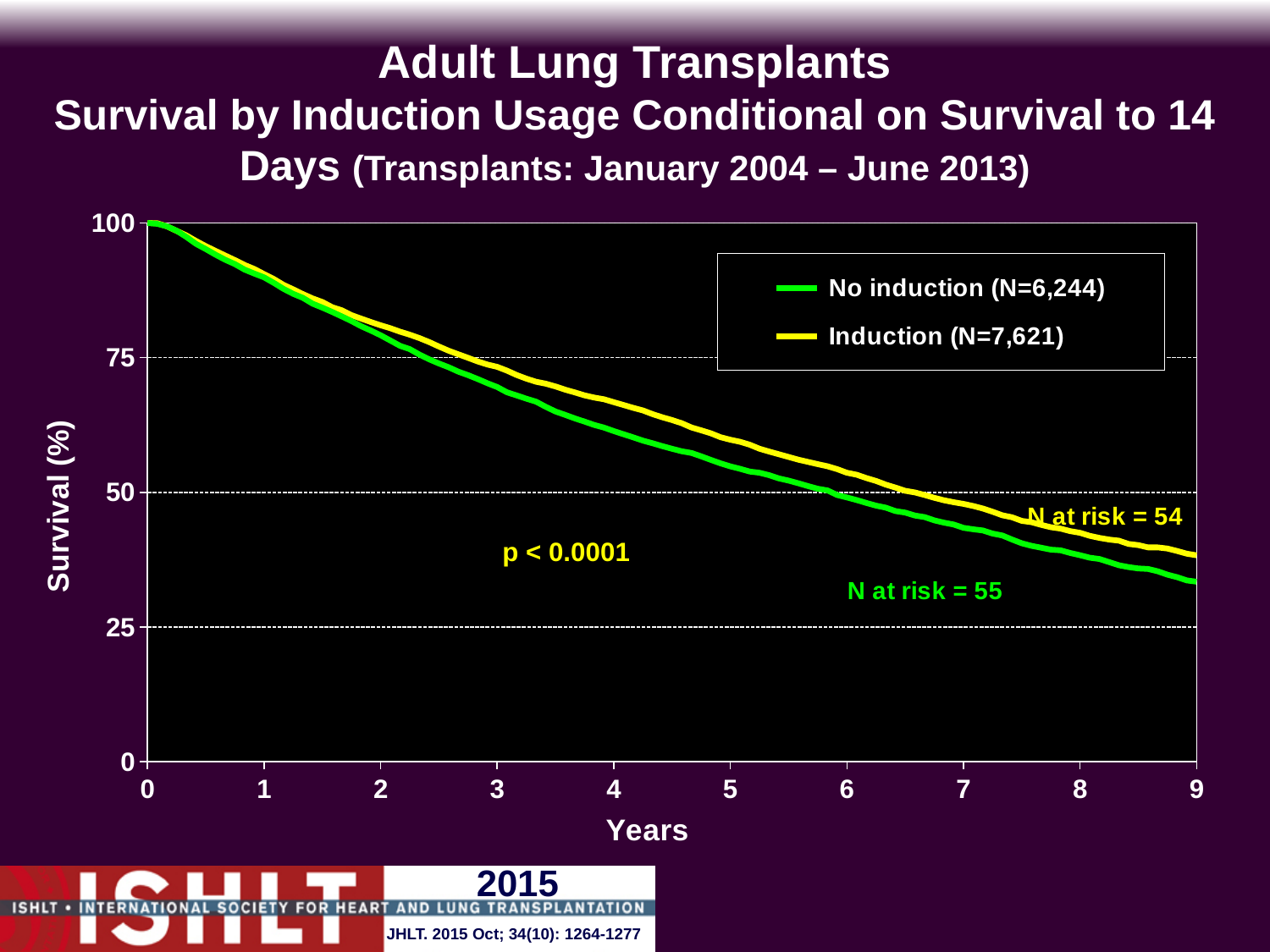
What kind of chart is shown on the slide? line chart How many series does the legend list? 2 Do the survival curves rise or fall as years increase? fall At 5 years, which curve shows higher survival, Induction or No induction? Induction What is the N at risk printed for the No induction curve? 55 Is the survival value for the Induction curve at 3 years greater or less than 50? greater What is the sample size (N) given in the legend for the No induction group? 6,244 What colour is the line for the No induction group? green What p-value is printed on the chart? p < 0.0001 Is the survival value for the No induction curve at 9 years greater or less than 50? less What is the N at risk printed for the Induction curve? 54 What is the sample size (N) given in the legend for the Induction group? 7,621